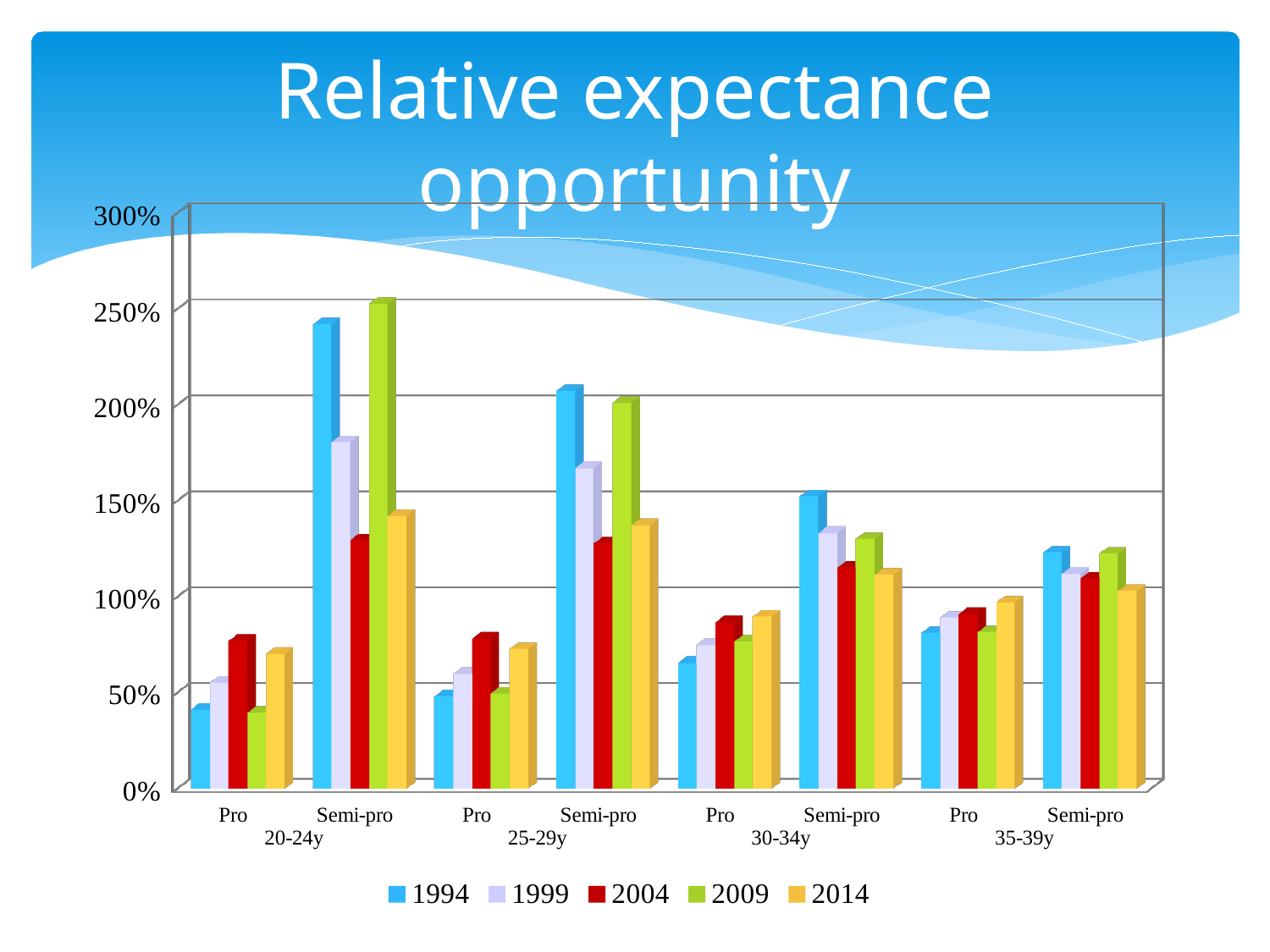
What kind of chart is shown on the slide? bar chart Which years are listed in the legend? 1994, 1999, 2004, 2009, 2014 Which category has the highest 2009 value? Semi-pro 20-24y How many categories are shown along the x axis? 8 Is the 2004 value for Semi-pro 20-24y greater or less than 100%? greater Is the 2009 value for Semi-pro 20-24y greater or less than 200%? greater What is the title of the chart? Relative expectance opportunity How many series does the legend list? 5 Is the 1994 value for Semi-pro 20-24y greater or less than 200%? greater Which is larger for 20-24y in 1994, the Pro value or the Semi-pro value? Semi-pro